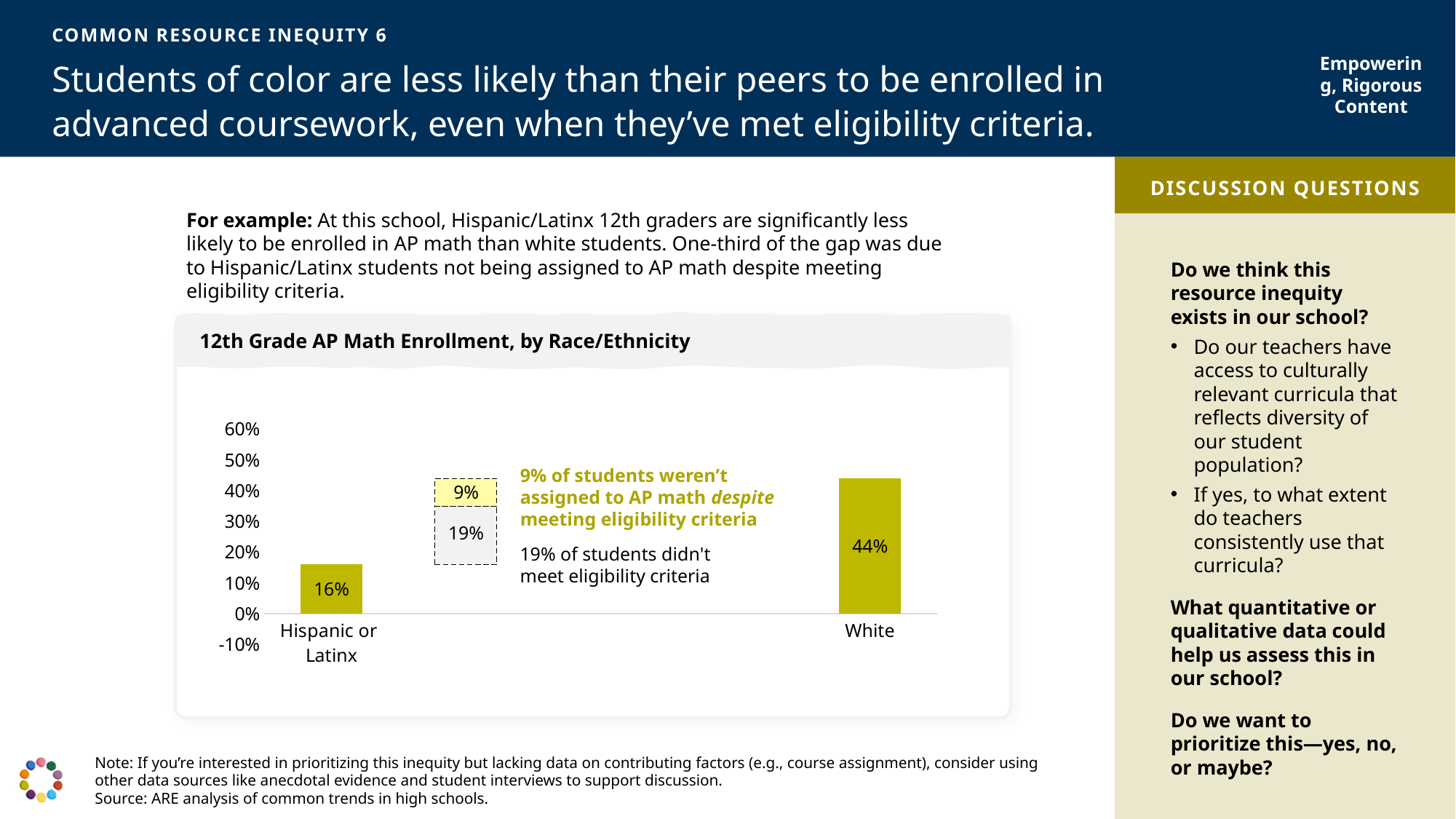
Is the AP math enrollment rate for Hispanic or Latinx students greater or less than 20%? less Is the AP math enrollment rate for White students greater or less than 40%? greater What percentage of students didn't meet eligibility criteria? 19% What is the 12th grade AP math enrollment rate for Hispanic or Latinx students? 16% What is the 12th grade AP math enrollment rate for White students? 44% What is the title of the chart? 12th Grade AP Math Enrollment, by Race/Ethnicity What is the highest value shown on the chart's vertical axis? 60% Which group has the higher AP math enrollment rate, Hispanic or Latinx students or White students? White What type of chart is used to show 12th grade AP math enrollment? Bar chart What is the difference in AP math enrollment between White students and Hispanic or Latinx students? 28 percentage points What percentage of students weren't assigned to AP math despite meeting eligibility criteria? 9% What is the combined total of the two gap segments (didn't meet eligibility criteria plus weren't assigned despite eligibility)? 28%